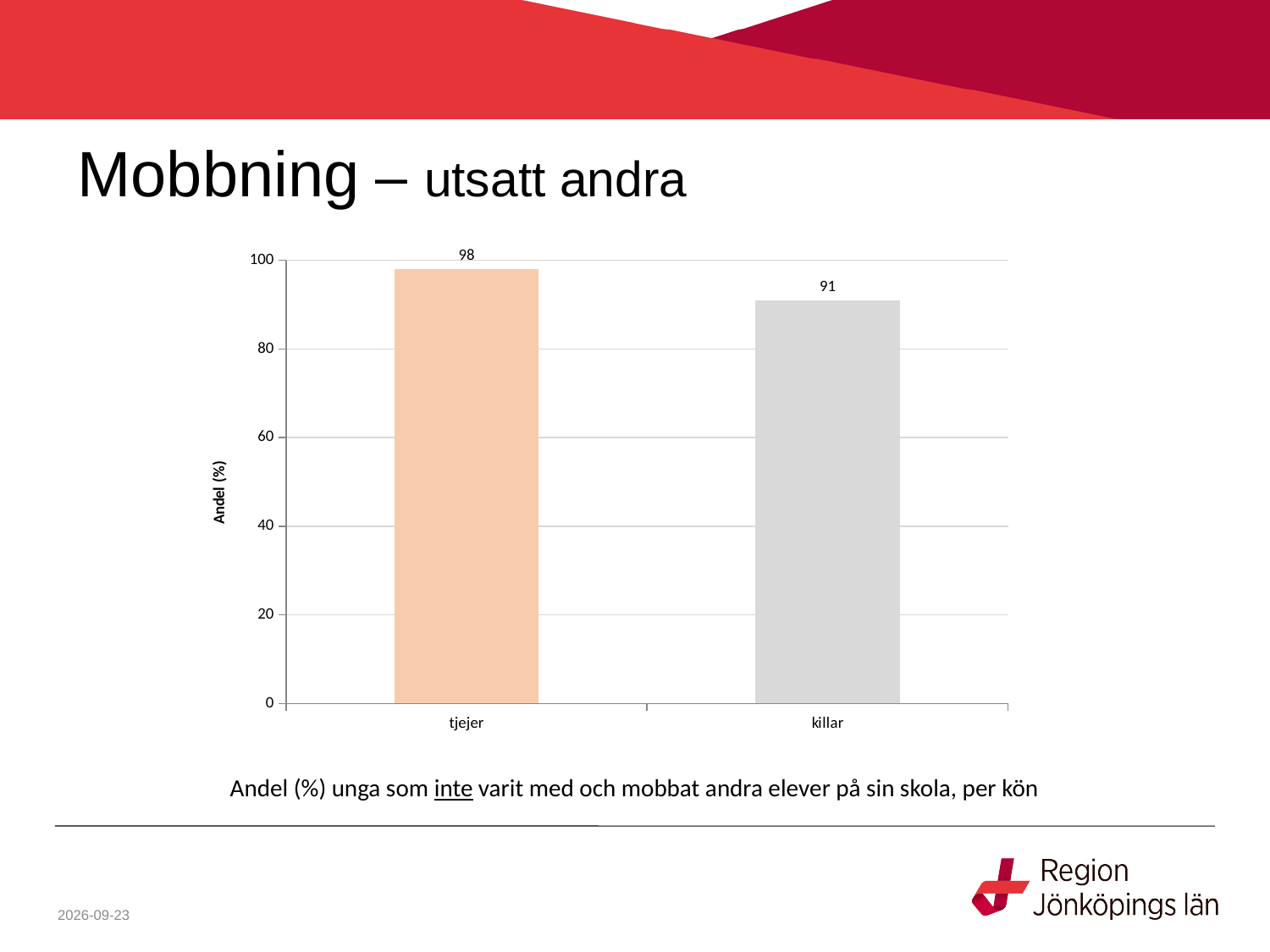
How many categories are shown on the x axis? 2 Which category has the highest value? tjejer What is the value for tjejer? 98 What is the value for killar? 91 What is the label of the y axis? Andel (%) What kind of chart is shown on the slide? bar chart What is the highest tick value shown on the y axis? 100 Which is larger, the value for tjejer or the value for killar? tjejer Which category has the lowest value? killar Is the value for killar greater or less than 80? greater What is the difference between the values for tjejer and killar? 7